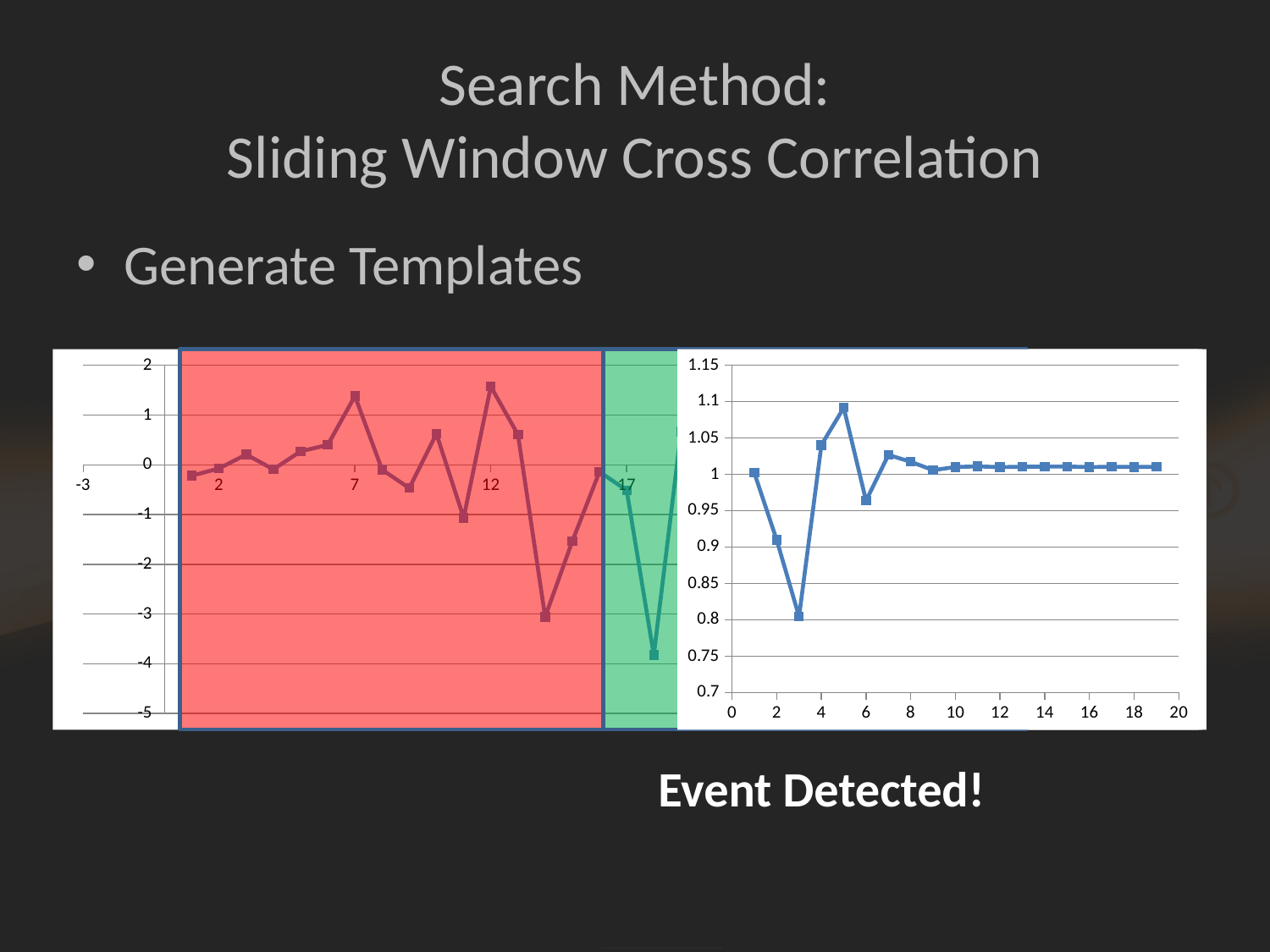
What kind of chart is the chart on the left of the slide with the red and green shaded regions? line chart What two colours are used to shade the regions in the chart on the left? red and green In the chart on the right, is the value at x = 3 larger or smaller than the value at x = 5? smaller In the chart on the right, is the value at x = 5 greater or less than 1.05? greater In the chart on the right, at which x value is the lowest point? 3 In the chart on the right, how many data points are plotted? 19 In the chart on the left, is the value at x = 7 greater or less than 1? greater In the chart on the right, at which x value is the highest point? 5 In the chart on the right, is the value at x = 6 greater or less than 1? less What kind of chart is the chart on the right of the slide? line chart